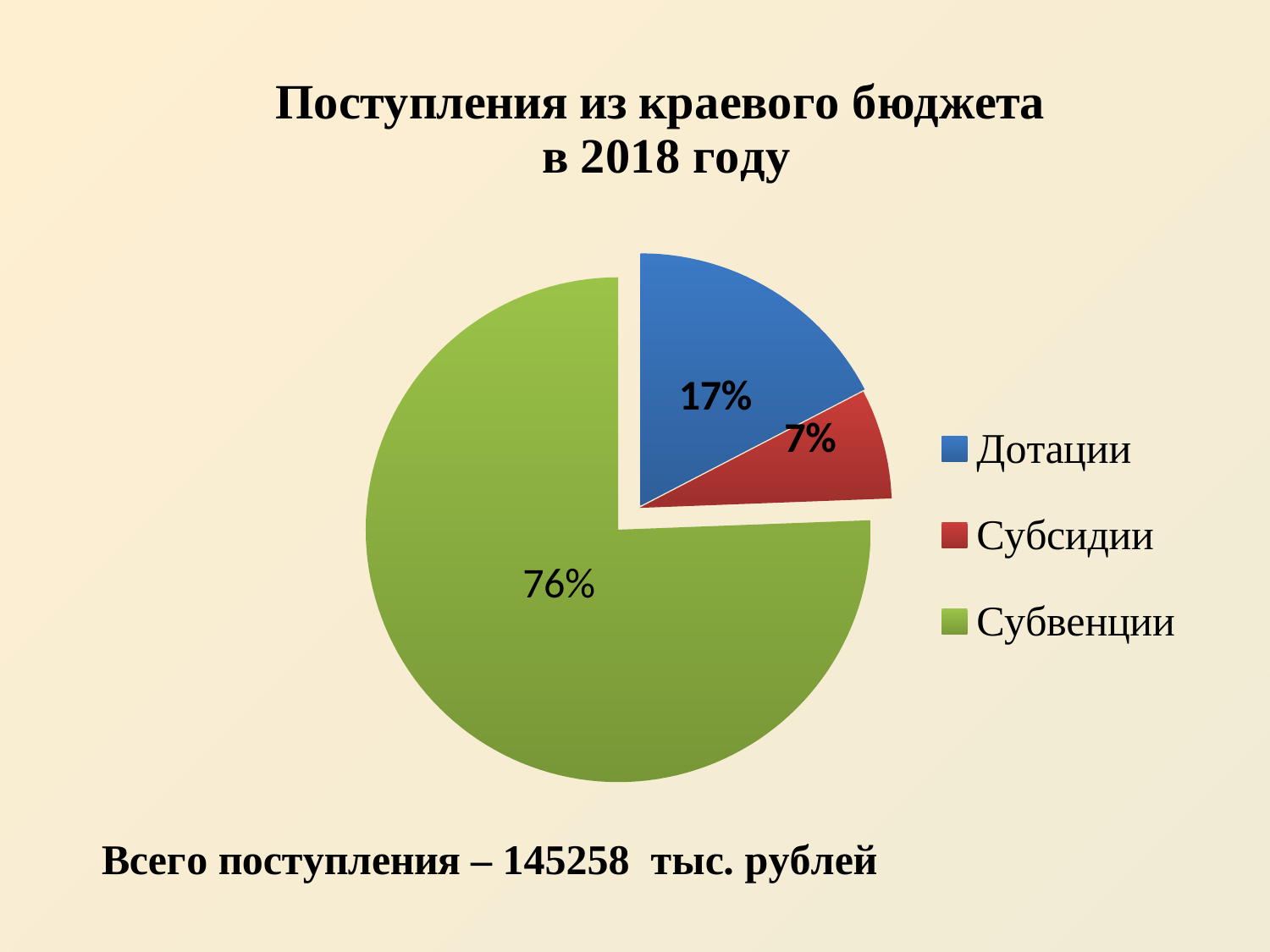
What is the value shown for Дотации? 17% Which category has the smallest slice of the pie? Субсидии What is the difference in percentage points between Субвенции and Дотации? 59 What is the title of the chart? Поступления из краевого бюджета в 2018 году Which is larger, Дотации or Субсидии? Дотации What share of the pie does Субвенции represent? 76% What kind of chart is shown on the slide? pie chart How many categories are shown in the pie chart? 3 What colour is the slice for Субсидии? red Which category has the largest slice of the pie? Субвенции What is the difference in percentage points between Дотации and Субсидии? 10 What is the value shown for Субсидии? 7%